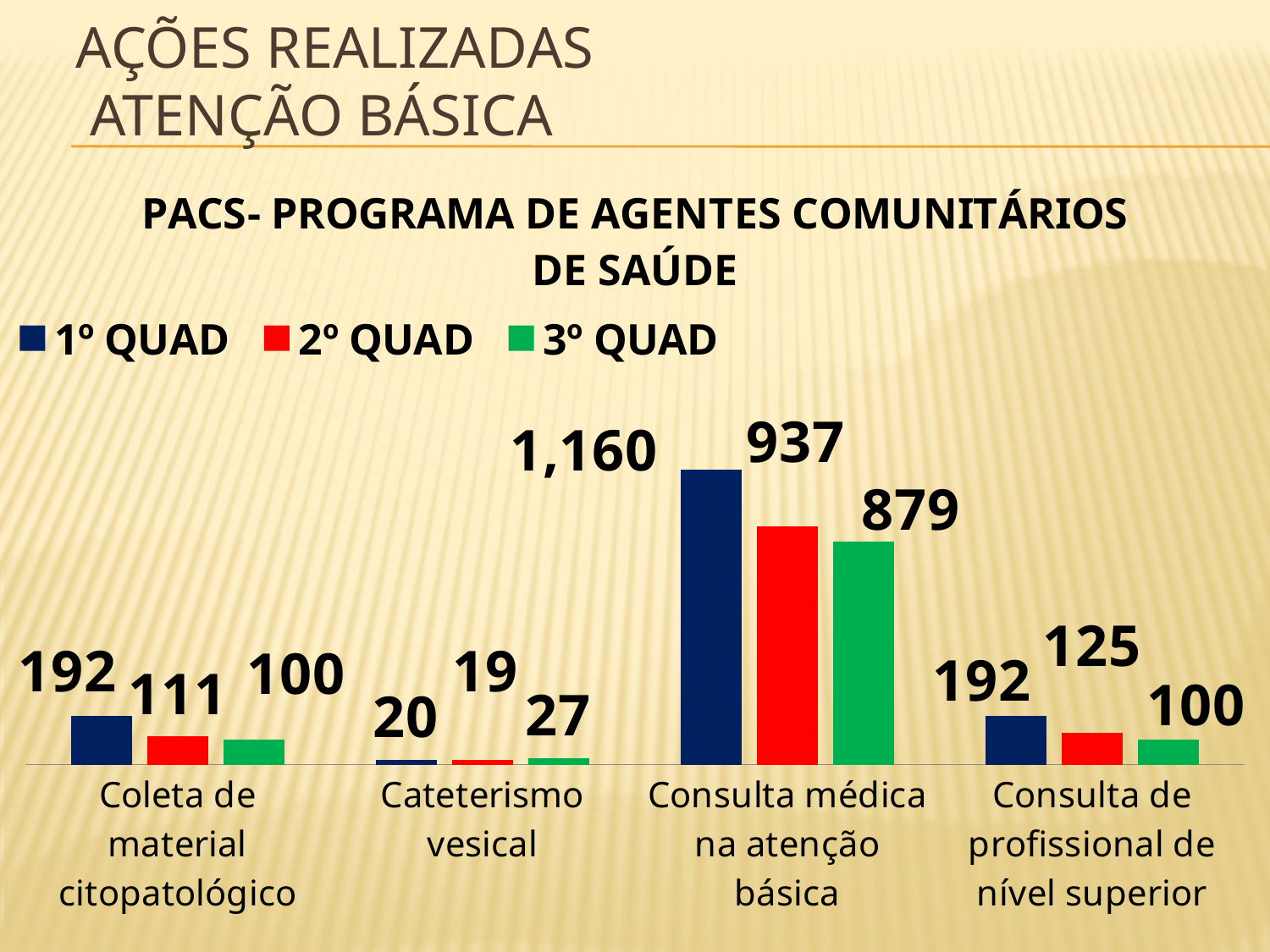
What is the value for 3º QUAD in the 'Cateterismo vesical' category? 27 Which is larger: the 2º QUAD value for 'Coleta de material citopatológico' or the 2º QUAD value for 'Consulta de profissional de nível superior'? Consulta de profissional de nível superior How many categories are shown on the x axis? 4 What is the value for 2º QUAD in the 'Consulta de profissional de nível superior' category? 125 What is the title of the chart? PACS- PROGRAMA DE AGENTES COMUNITÁRIOS DE SAÚDE What kind of chart is shown on the slide? Bar chart What is the difference between the 1º QUAD and 3º QUAD values for 'Consulta médica na atenção básica'? 281 How many series does the legend list? 3 What is the difference between the 1º QUAD and 2º QUAD values for 'Coleta de material citopatológico'? 81 What is the value for 1º QUAD in the 'Consulta médica na atenção básica' category? 1,160 Which category has the highest value for 1º QUAD? Consulta médica na atenção básica Which category has the lowest value for 2º QUAD? Cateterismo vesical